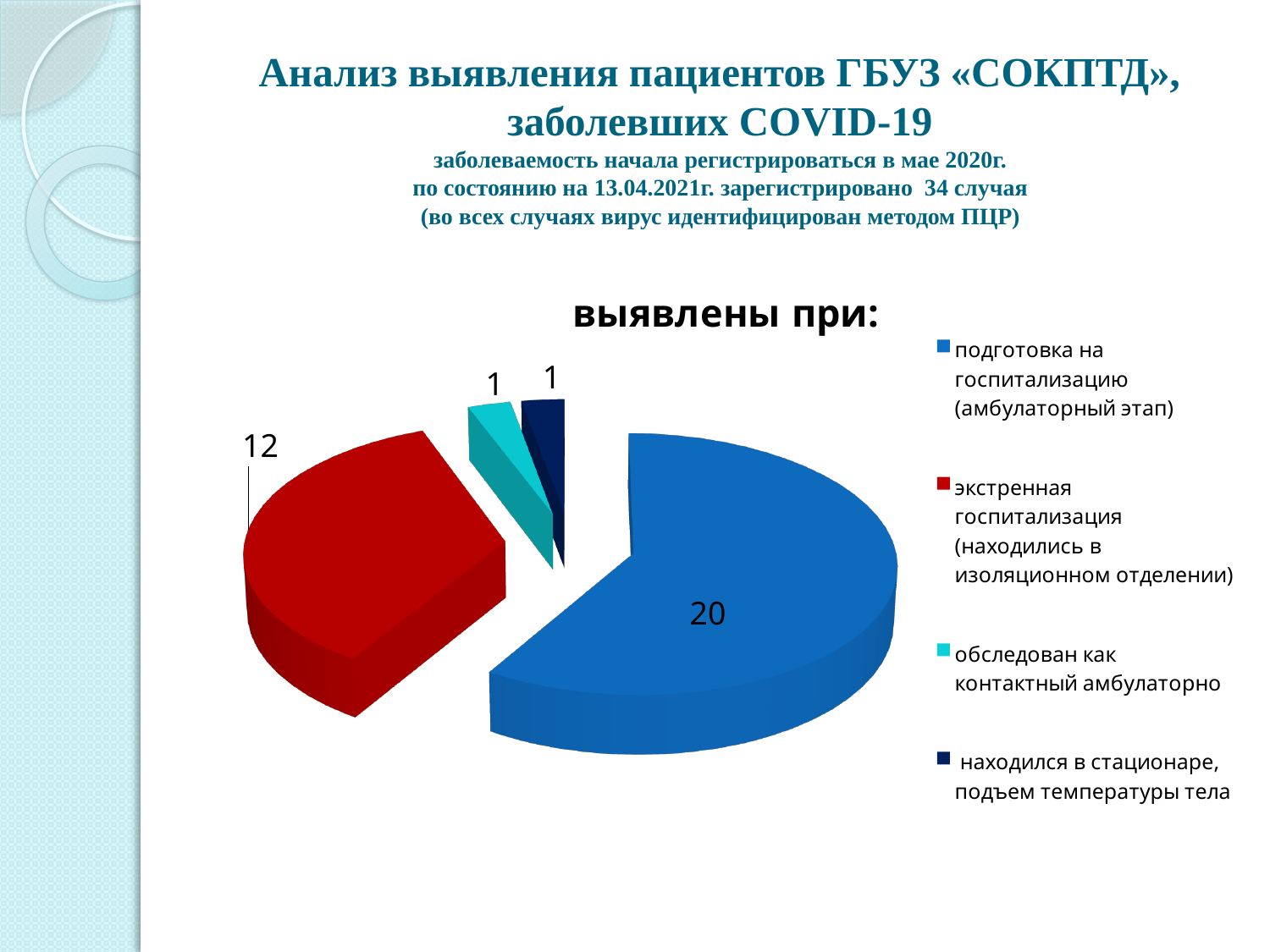
What share of the pie does 'подготовка на госпитализацию (амбулаторный этап)' represent? 58.8% What is the title of the chart? выявлены при: What is the value for 'обследован как контактный амбулаторно'? 1 What colour is the slice for 'экстренная госпитализация (находились в изоляционном отделении)'? red What kind of chart is shown on the slide? pie chart What is the difference between the values for 'подготовка на госпитализацию (амбулаторный этап)' and 'экстренная госпитализация'? 8 What is the value for 'экстренная госпитализация (находились в изоляционном отделении)'? 12 How many slices does the pie chart have? 4 Which is larger: the value for 'экстренная госпитализация' or the value for 'находился в стационаре, подъем температуры тела'? экстренная госпитализация What is the total of all slices in the pie chart? 34 Which category has the largest slice of the pie? подготовка на госпитализацию (амбулаторный этап) What is the value for 'подготовка на госпитализацию (амбулаторный этап)'? 20